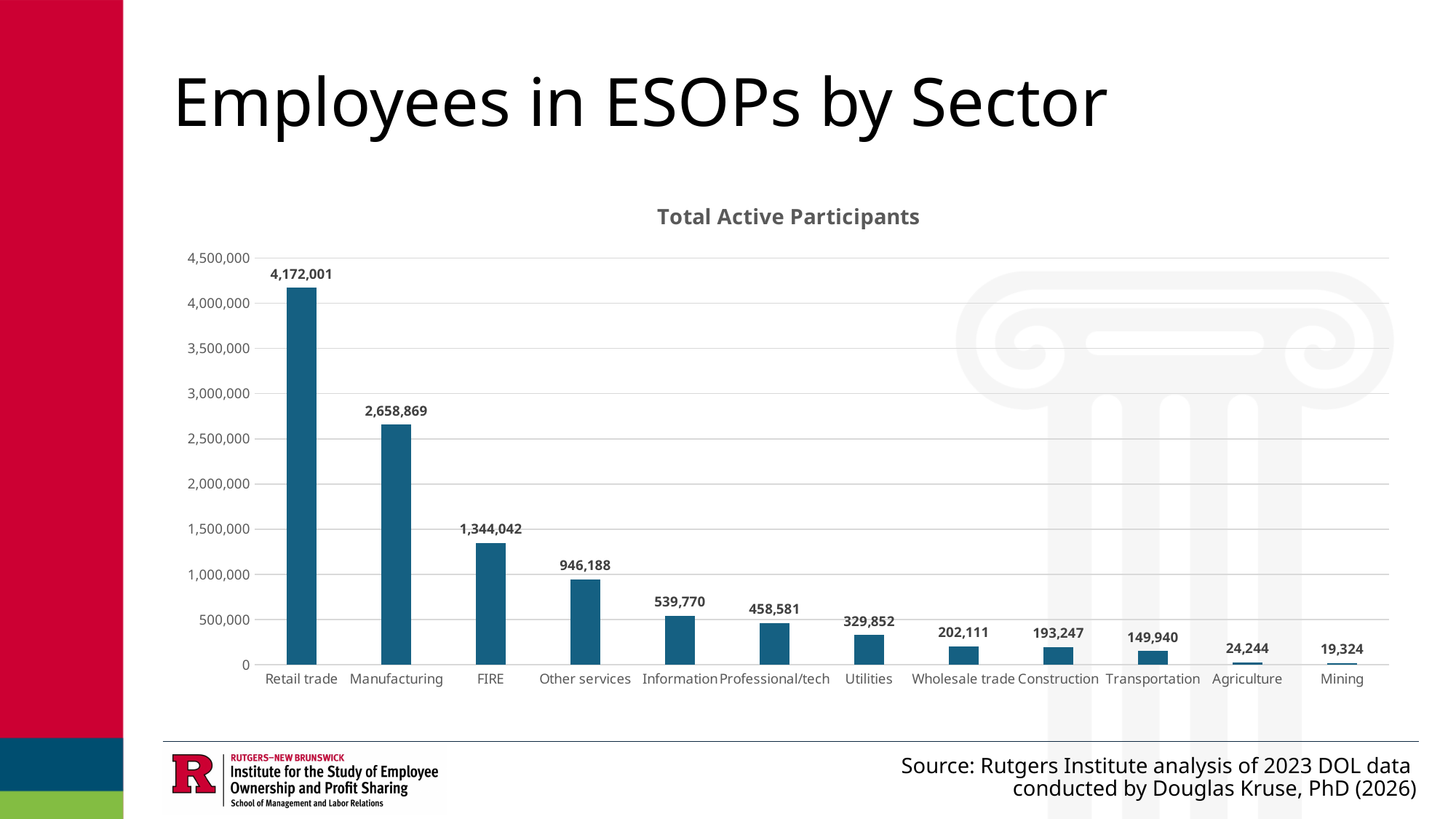
What is the difference between the values for Agriculture and Mining? 4,920 Is the value for Other services greater or less than 1,000,000? less What kind of chart is shown on the slide? bar chart Which is larger, the value for Information or the value for Professional/tech? Information What is the value for Utilities? 329,852 How many sectors are shown on the chart? 12 Which sector has the highest number of total active participants? Retail trade What is the value for Retail trade? 4,172,001 Which sector has the lowest number of total active participants? Mining What is the difference between the values for Retail trade and Manufacturing? 1,513,132 What is the value for FIRE? 1,344,042 What is the value for Transportation? 149,940